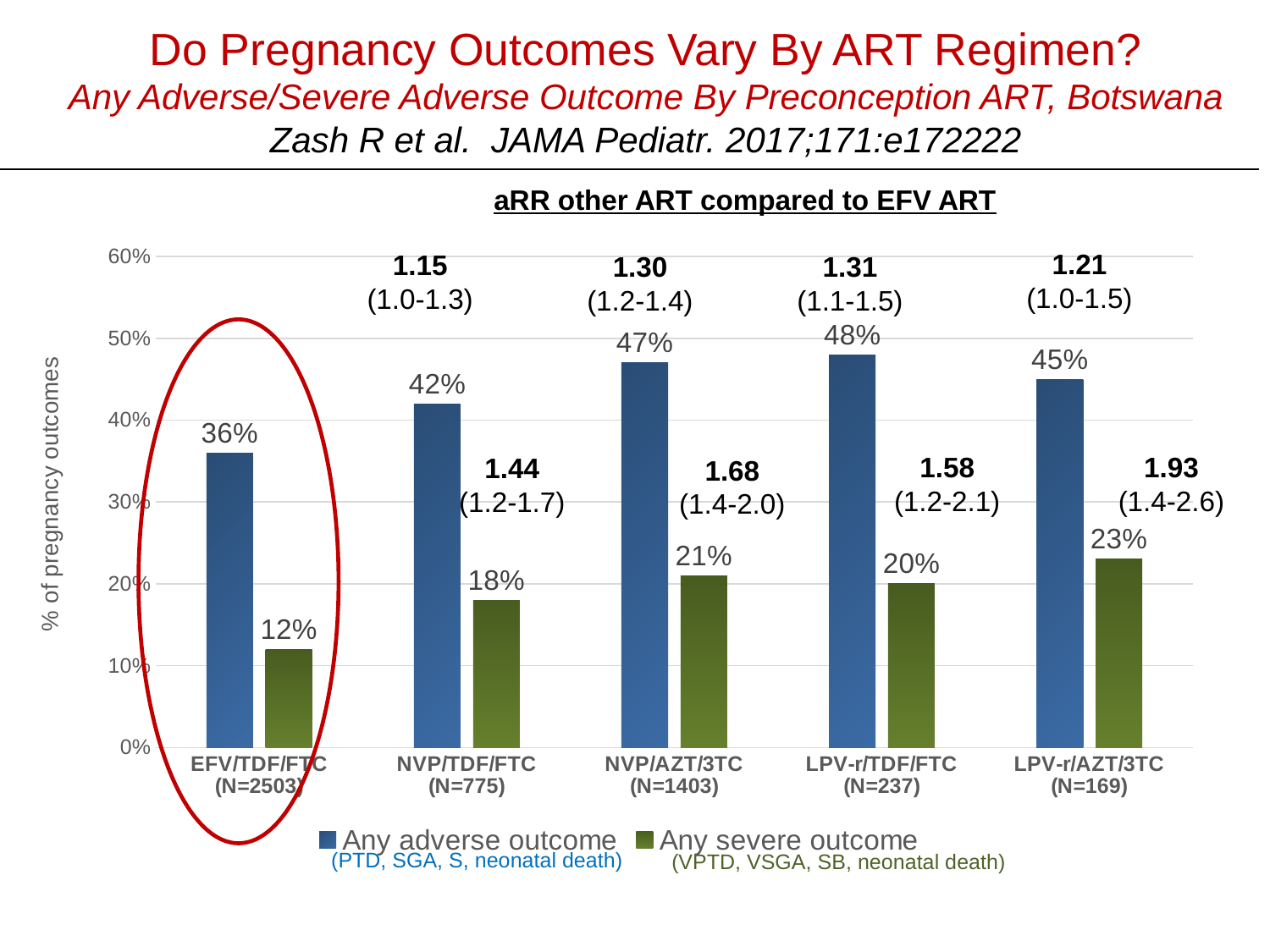
What is the difference between Any adverse outcome and Any severe outcome for NVP/TDF/FTC? 24% What is the y-axis label of the chart? % of pregnancy outcomes Which is larger: Any severe outcome for NVP/AZT/3TC or for LPV-r/TDF/FTC? NVP/AZT/3TC What is the value for Any severe outcome for LPV-r/AZT/3TC? 23% What is the value for Any adverse outcome for NVP/AZT/3TC? 47% How many series does the legend list? 2 Which regimen has the highest value for Any adverse outcome? LPV-r/TDF/FTC What colour are the bars for Any severe outcome? Green How many regimen categories are shown on the x axis? 5 Which regimen has the lowest value for Any severe outcome? EFV/TDF/FTC What is the value for Any adverse outcome for EFV/TDF/FTC? 36% What kind of chart is shown on the slide? Bar chart